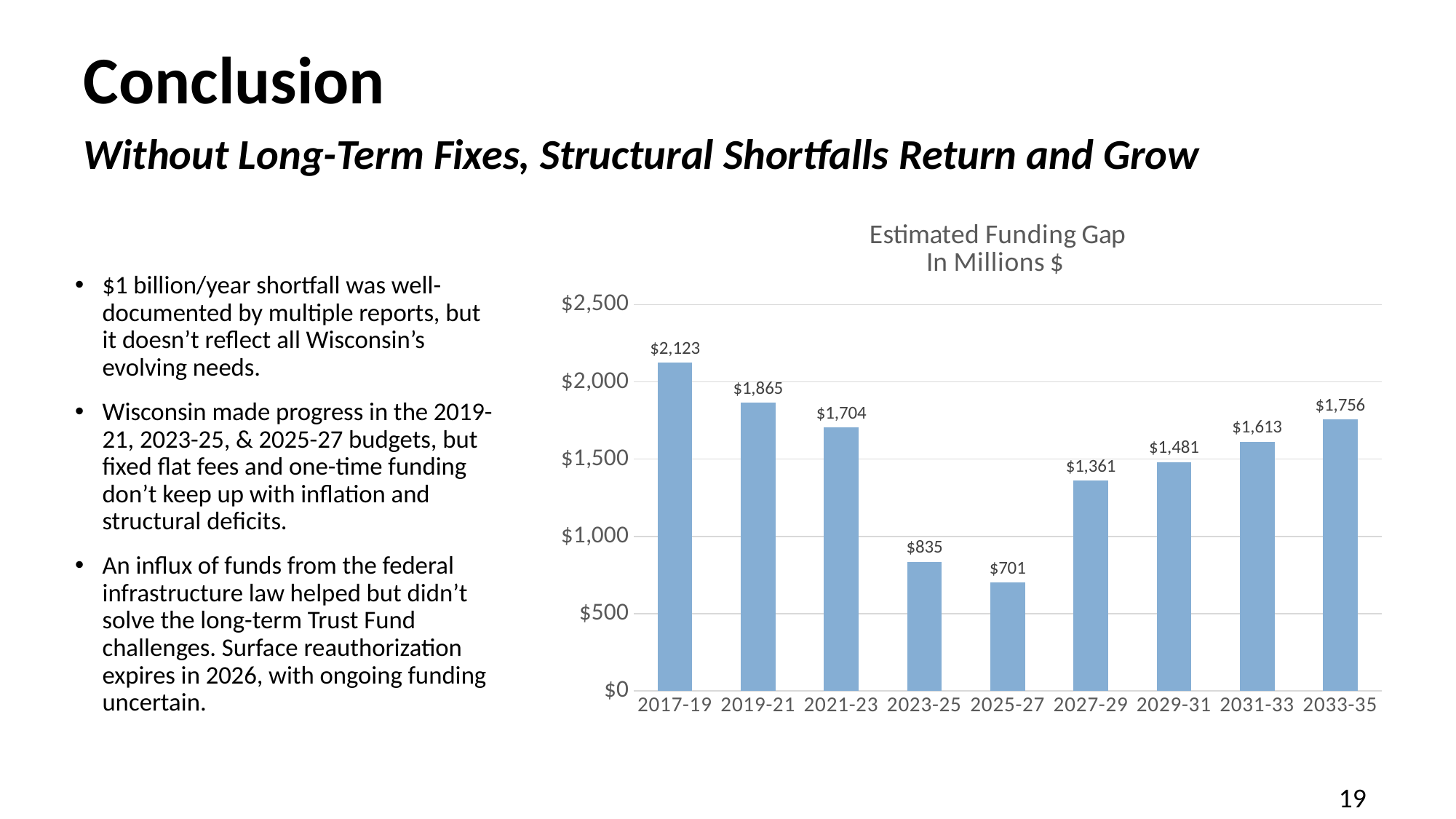
Which is larger, the estimated funding gap for 2019-21 or for 2033-35? 2019-21 What kind of chart is used to show the estimated funding gap? bar chart Is the estimated funding gap for 2023-25 greater or less than $1,000? less Do the estimated funding gap values rise or fall from 2025-27 to 2033-35? rise What is the estimated funding gap for 2017-19? $2,123 Which period has the lowest estimated funding gap? 2025-27 What is the difference between the estimated funding gap for 2017-19 and 2025-27? $1,422 What is the estimated funding gap for 2033-35? $1,756 What is the difference between the estimated funding gap for 2033-35 and 2031-33? $143 Which period has the highest estimated funding gap? 2017-19 What is the estimated funding gap for 2025-27? $701 How many budget periods are shown on the chart? 9